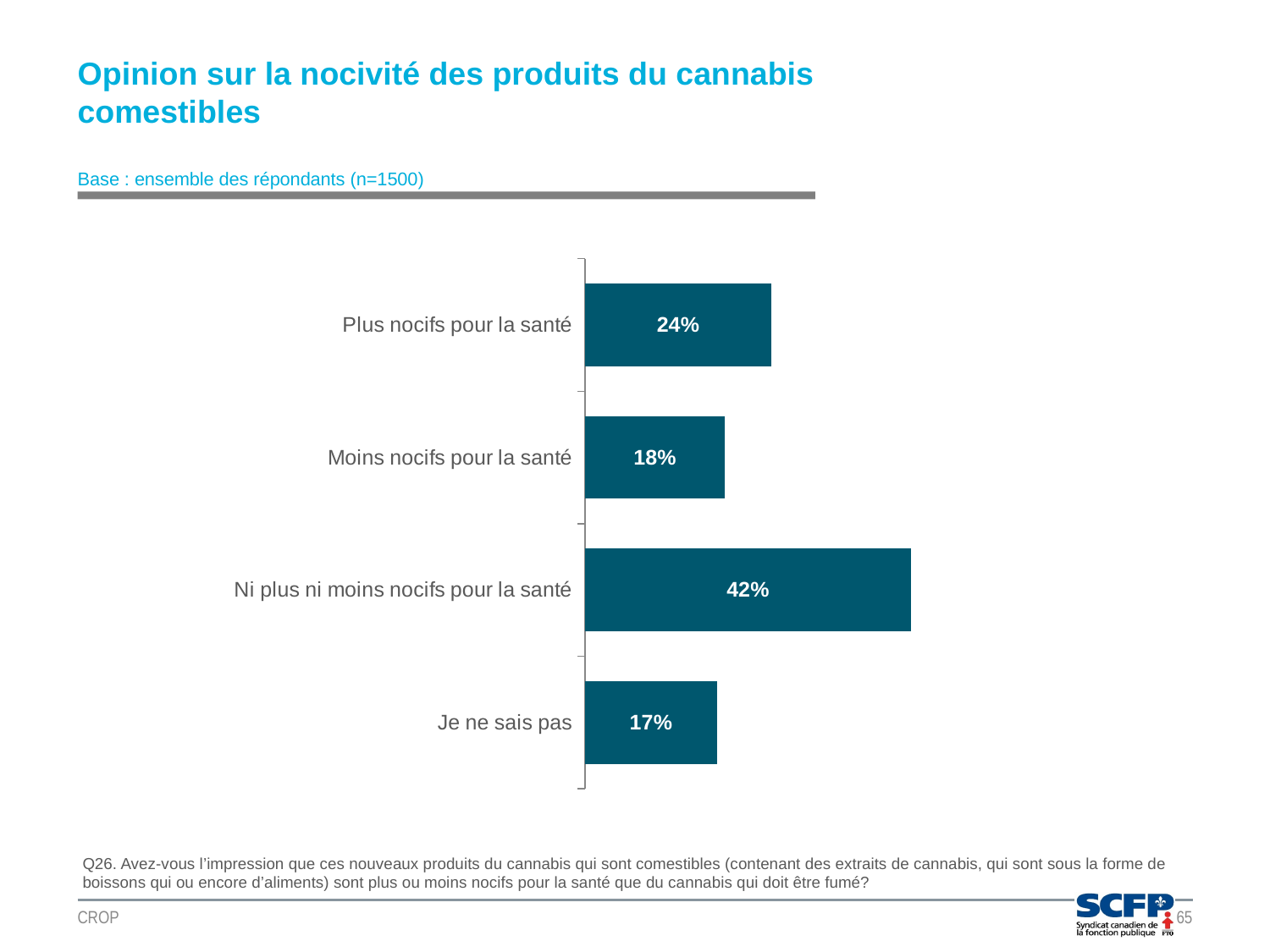
Which category has the highest value? Ni plus ni moins nocifs pour la santé What is the difference between "Ni plus ni moins nocifs pour la santé" and "Plus nocifs pour la santé"? 18% What kind of chart is shown on the slide? Bar chart What is the value for "Ni plus ni moins nocifs pour la santé"? 42% What is the base (number of respondents) stated for the chart? n=1500 What is the value for "Je ne sais pas"? 17% What is the value for "Plus nocifs pour la santé"? 24% Which category has the lowest value? Je ne sais pas What is the value for "Moins nocifs pour la santé"? 18% How many categories are shown in the chart? 4 Which is larger, "Plus nocifs pour la santé" or "Moins nocifs pour la santé"? Plus nocifs pour la santé What is the difference between "Plus nocifs pour la santé" and "Moins nocifs pour la santé"? 6%